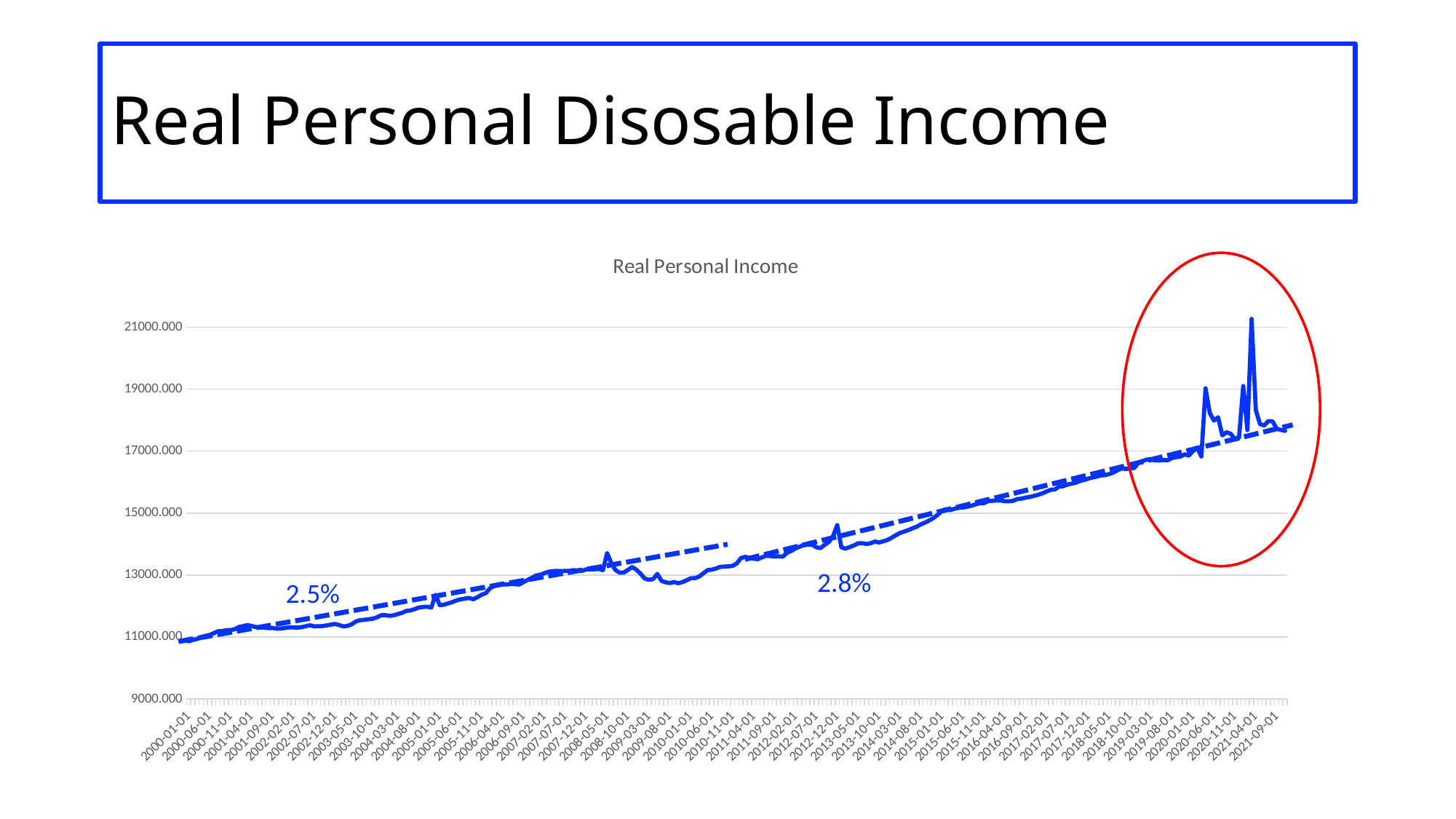
Is the value at 2021-09-01 greater or less than 17000.000? greater Is the value at 2000-01-01 greater or less than 13000.000? less Is the value around 2009-08-01 greater or less than 13000.000? less In which year does the series reach its highest value? 2021 Which is larger, the value at 2021-09-01 or the value at 2000-01-01? 2021-09-01 What growth rate is annotated next to the left dashed trend line? 2.5% What kind of chart is shown on the slide? line chart Do the values in the Real Personal Income chart generally rise or fall from 2000 to 2021? rise What growth rate is annotated next to the right dashed trend line? 2.8%